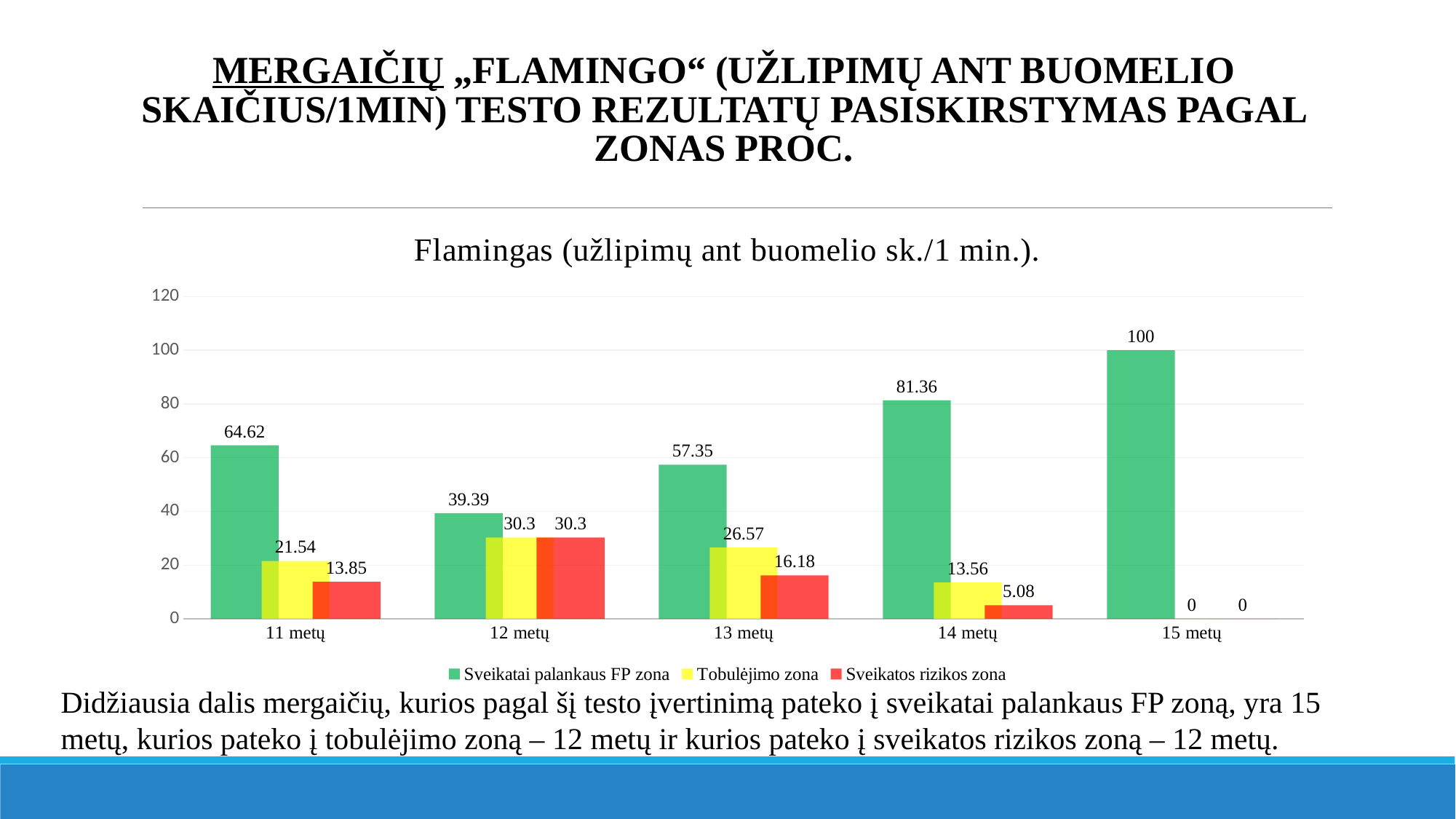
What is the title of the chart? Flamingas (užlipimų ant buomelio sk./1 min.). What is the difference between the Sveikatai palankaus FP zona values for 14 metų and 13 metų? 24.01 Is the value of Sveikatai palankaus FP zona for 12 metų greater or less than 40? less Which is larger: the Tobulėjimo zona value for 11 metų or for 12 metų? 12 metų What type of chart is shown on the slide? bar chart How many age groups are shown on the x axis? 5 How many series does the legend list? 3 Which age group has the highest value for Sveikatai palankaus FP zona? 15 metų What is the value of Sveikatos rizikos zona for 14 metų? 5.08 What is the value of Tobulėjimo zona for 13 metų? 26.57 What is the value of Sveikatai palankaus FP zona for 11 metų? 64.62 Which age group has the lowest value for Tobulėjimo zona? 15 metų